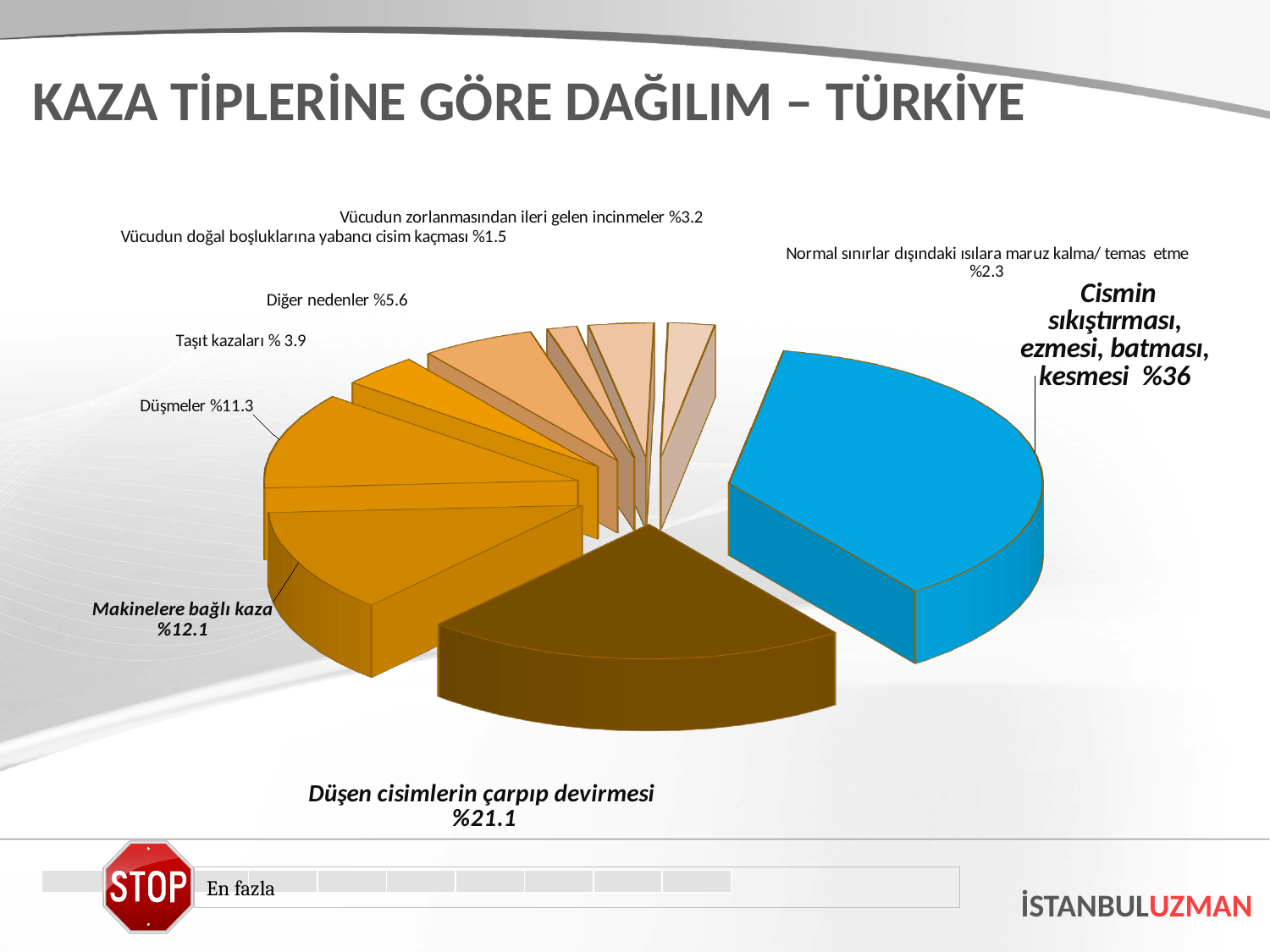
What is the difference between the shares of Makinelere bağlı kaza and Düşmeler? 0.8 percentage points What kind of chart is shown on the slide? Pie chart Which is larger, Taşıt kazaları or Vücudun zorlanmasından ileri gelen incinmeler? Taşıt kazaları How many percentage points larger is Cismin sıkıştırması, ezmesi, batması, kesmesi than Düşen cisimlerin çarpıp devirmesi? 14.9 percentage points Which accident type has the smallest share in the pie chart? Vücudun doğal boşluklarına yabancı cisim kaçması Which has the larger share, Düşmeler or Makinelere bağlı kaza? Makinelere bağlı kaza What percentage does the pie chart show for Düşmeler? %11.3 What value is shown for Taşıt kazaları? % 3.9 What percentage is labelled for Normal sınırlar dışındaki ısılara maruz kalma/ temas etme? %2.3 What share does the pie chart give for Makinelere bağlı kaza? %12.1 Which accident type has the largest share in the pie chart? Cismin sıkıştırması, ezmesi, batması, kesmesi What is the title of the slide? KAZA TİPLERİNE GÖRE DAĞILIM – TÜRKİYE